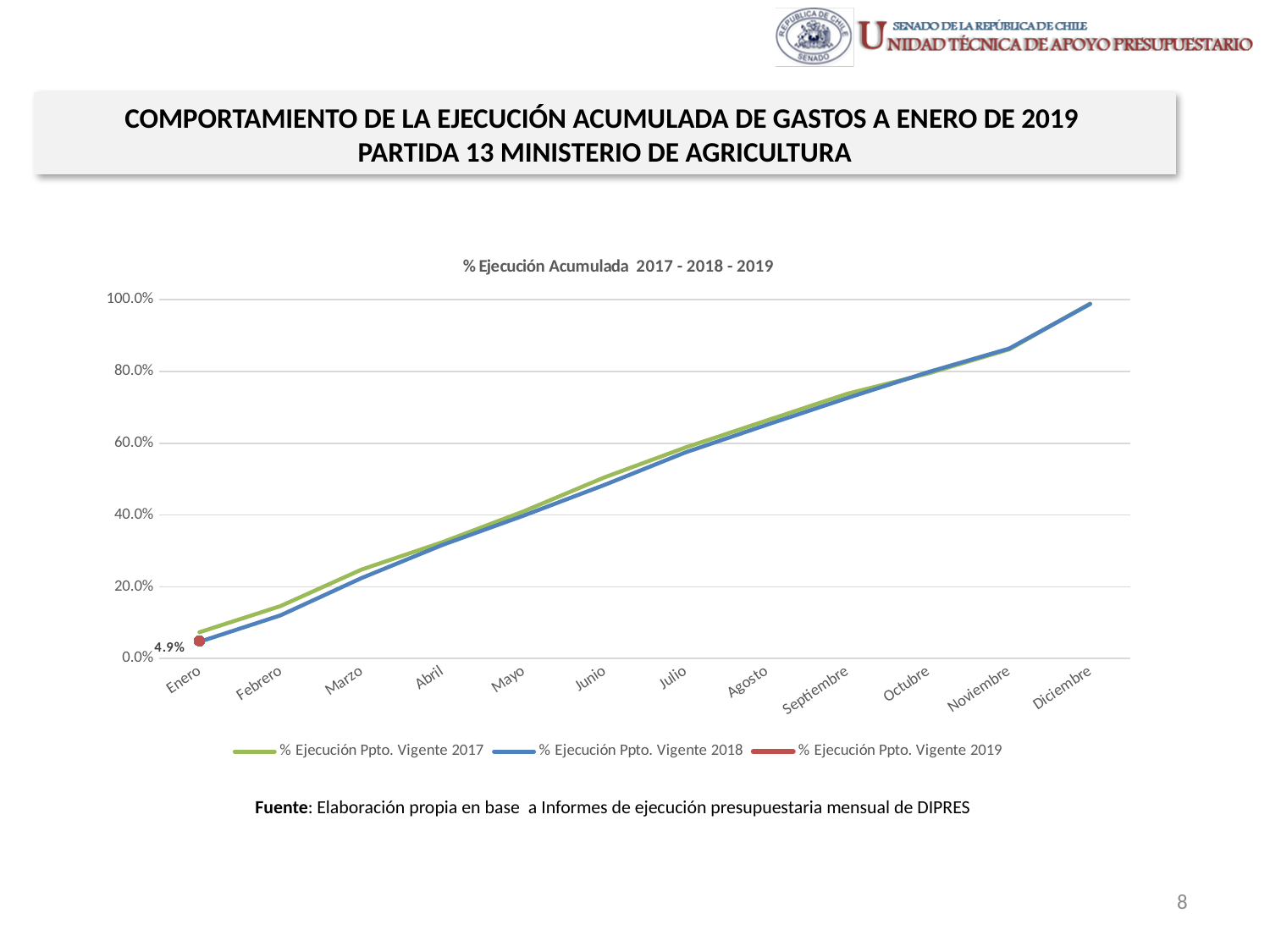
What is the title of the chart? % Ejecución Acumulada 2017 - 2018 - 2019 How many series does the chart legend list? 3 Is the value for % Ejecución Ppto. Vigente 2018 in Diciembre greater or less than 80%? greater What kind of chart is shown on the slide? line chart In Febrero, which series has the higher value: % Ejecución Ppto. Vigente 2017 or % Ejecución Ppto. Vigente 2018? % Ejecución Ppto. Vigente 2017 Do the values of % Ejecución Ppto. Vigente 2018 rise or fall from Enero to Diciembre? rise Which month has the highest value for % Ejecución Ppto. Vigente 2018? Diciembre Is the value for % Ejecución Ppto. Vigente 2017 in Enero greater or less than 20%? less Is the value for % Ejecución Ppto. Vigente 2018 in Junio greater or less than 60%? less What is the value of % Ejecución Ppto. Vigente 2019 for Enero? 4.9% How many months are shown along the x axis of the chart? 12 Which month has the lowest value for % Ejecución Ppto. Vigente 2017? Enero